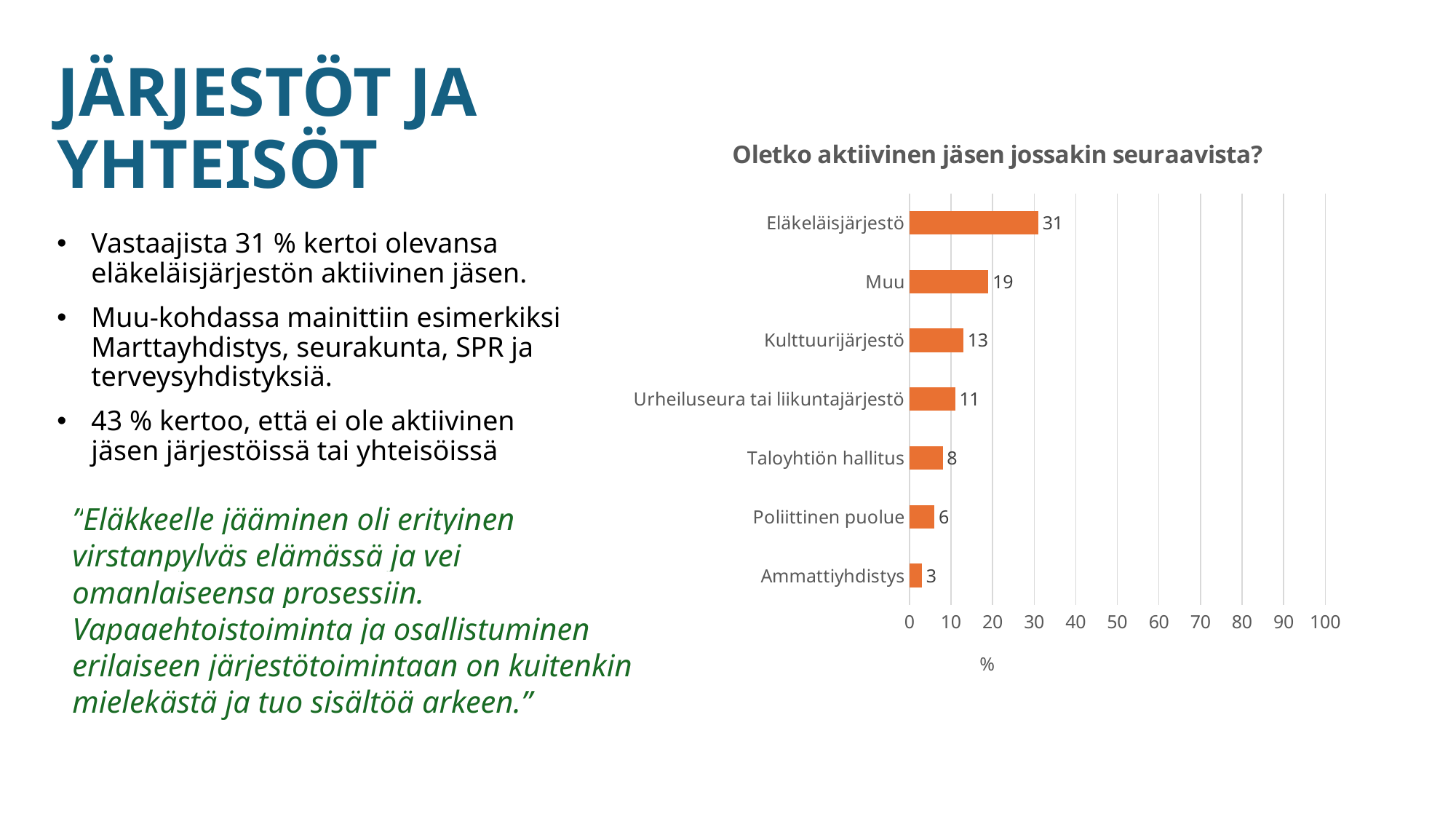
Which category has the highest value? Eläkeläisjärjestö What is the difference between the values for Eläkeläisjärjestö and Muu? 12 Which is larger, the value for Urheiluseura tai liikuntajärjestö or the value for Poliittinen puolue? Urheiluseura tai liikuntajärjestö Is the value for Muu greater or less than 20? less What is the value for Taloyhtiön hallitus? 8 What kind of chart is shown on the slide? bar chart How many categories are shown in the chart? 7 What is the value for Kulttuurijärjestö? 13 What is the title of the chart? Oletko aktiivinen jäsen jossakin seuraavista? What is the label on the horizontal axis of the chart? % What is the value for Eläkeläisjärjestö? 31 Which category has the lowest value? Ammattiyhdistys